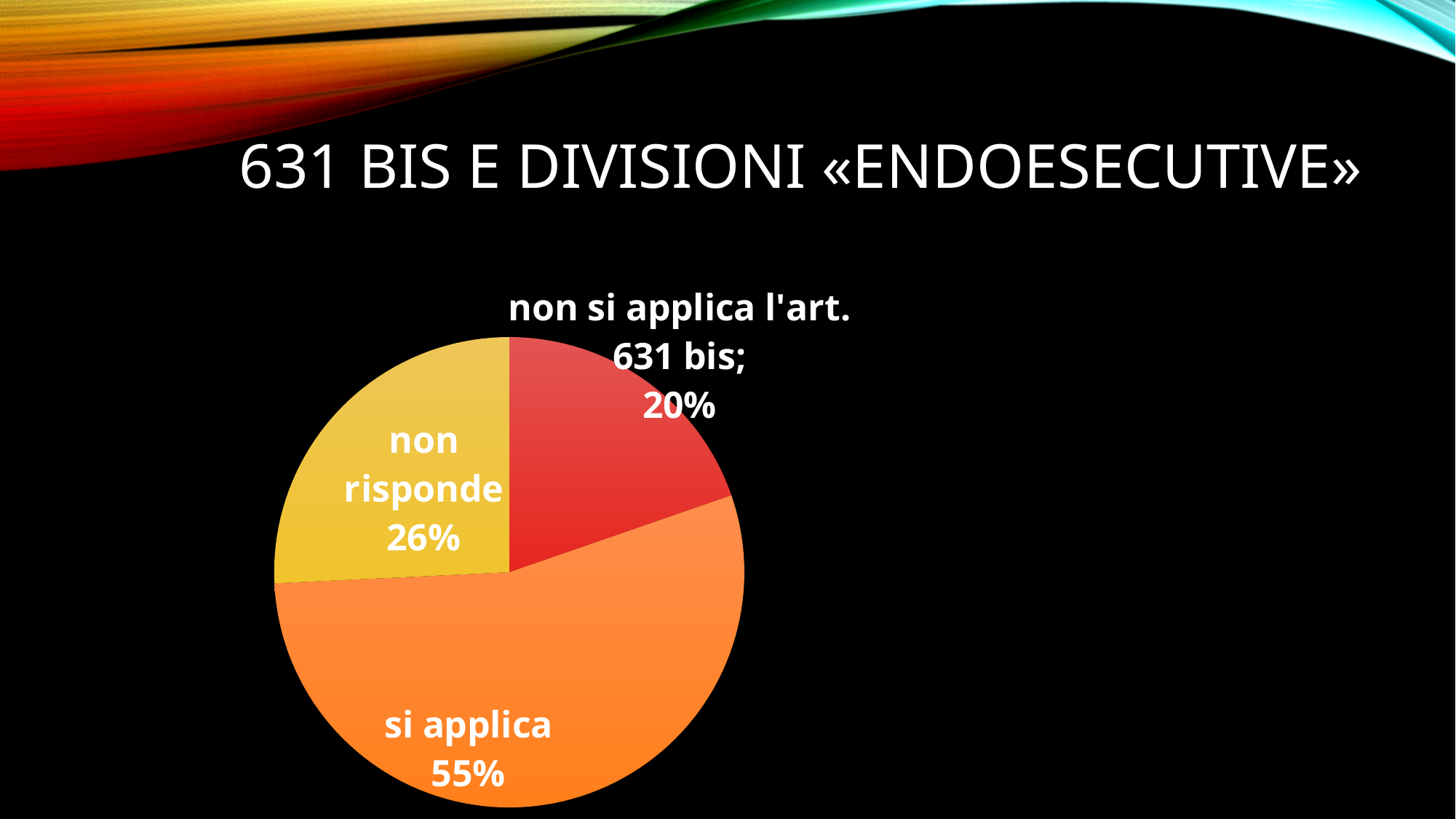
What kind of chart is shown on the slide? pie chart Which slice of the pie is the largest? si applica What share of the pie does "si applica" represent? 55% What is the difference in percentage points between "non risponde" and "non si applica l'art. 631 bis"? 6 What is the title of the slide containing the chart? 631 BIS E DIVISIONI «ENDOESECUTIVE» What share of the pie does "non si applica l'art. 631 bis" represent? 20% What is the difference in percentage points between "si applica" and "non risponde"? 29 Which is larger, the share for "non risponde" or the share for "non si applica l'art. 631 bis"? non risponde How many slices does the pie chart have? 3 What share of the pie does "non risponde" represent? 26% What colour is the "si applica" slice? orange Which slice of the pie is the smallest? non si applica l'art. 631 bis